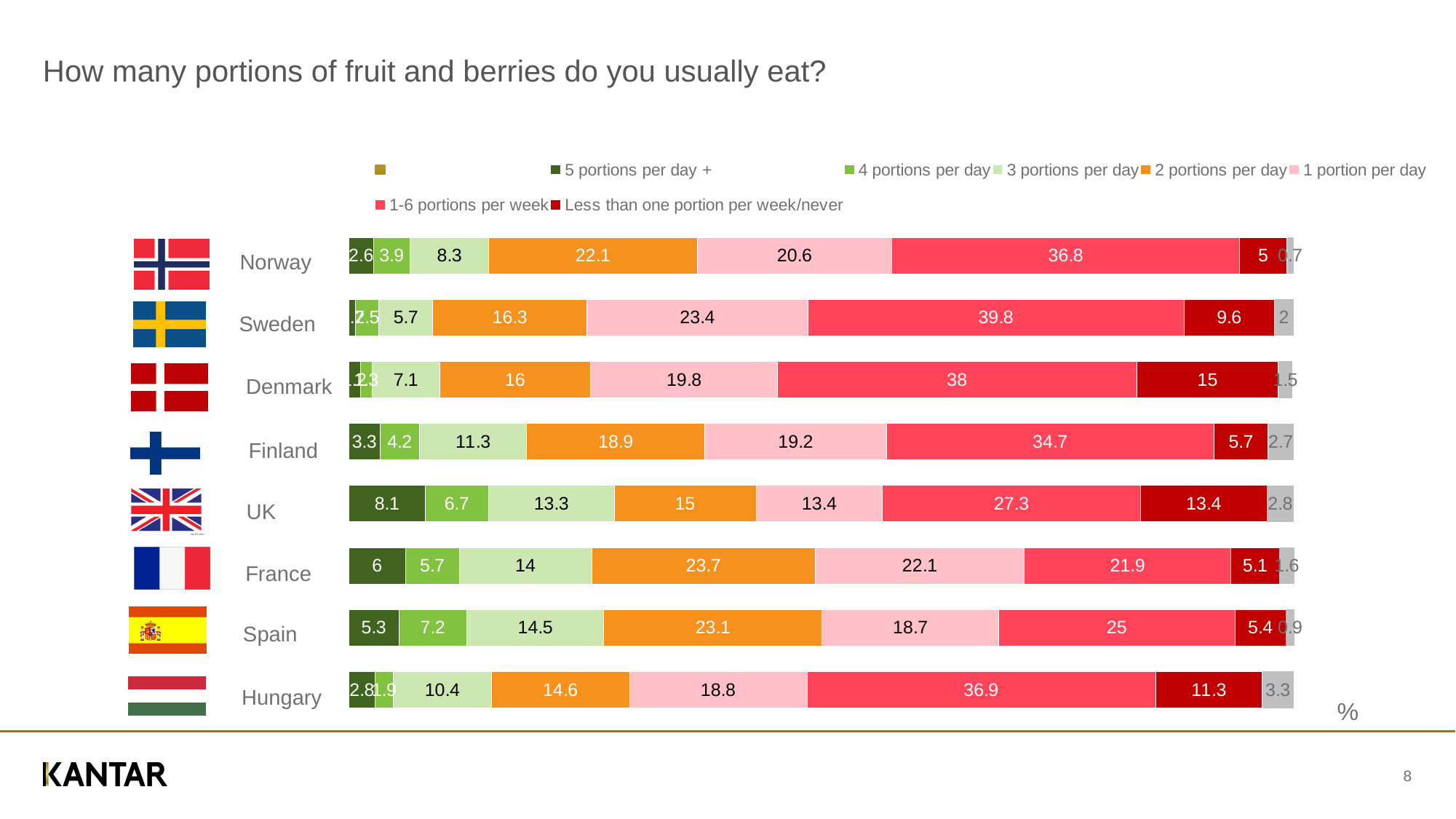
What type of chart is shown on the slide? Stacked bar chart Which is larger for 1 portion per day: Norway or Finland? Norway How many countries are shown in the chart? 8 What percentage of respondents in Sweden eat 1-6 portions per week? 39.8 What is the value for 1-6 portions per week in Spain? 25 What is the value for 3 portions per day in Denmark? 7.1 What is the difference between France and Hungary for 2 portions per day? 9.1 Which country has the highest value for Less than one portion per week/never? Denmark Which legend entry is shown in dark red? Less than one portion per week/never Which country has the highest value for 5 portions per day +? UK Which country has the highest value for 1-6 portions per week? Sweden What is the value for 5 portions per day + in the UK? 8.1